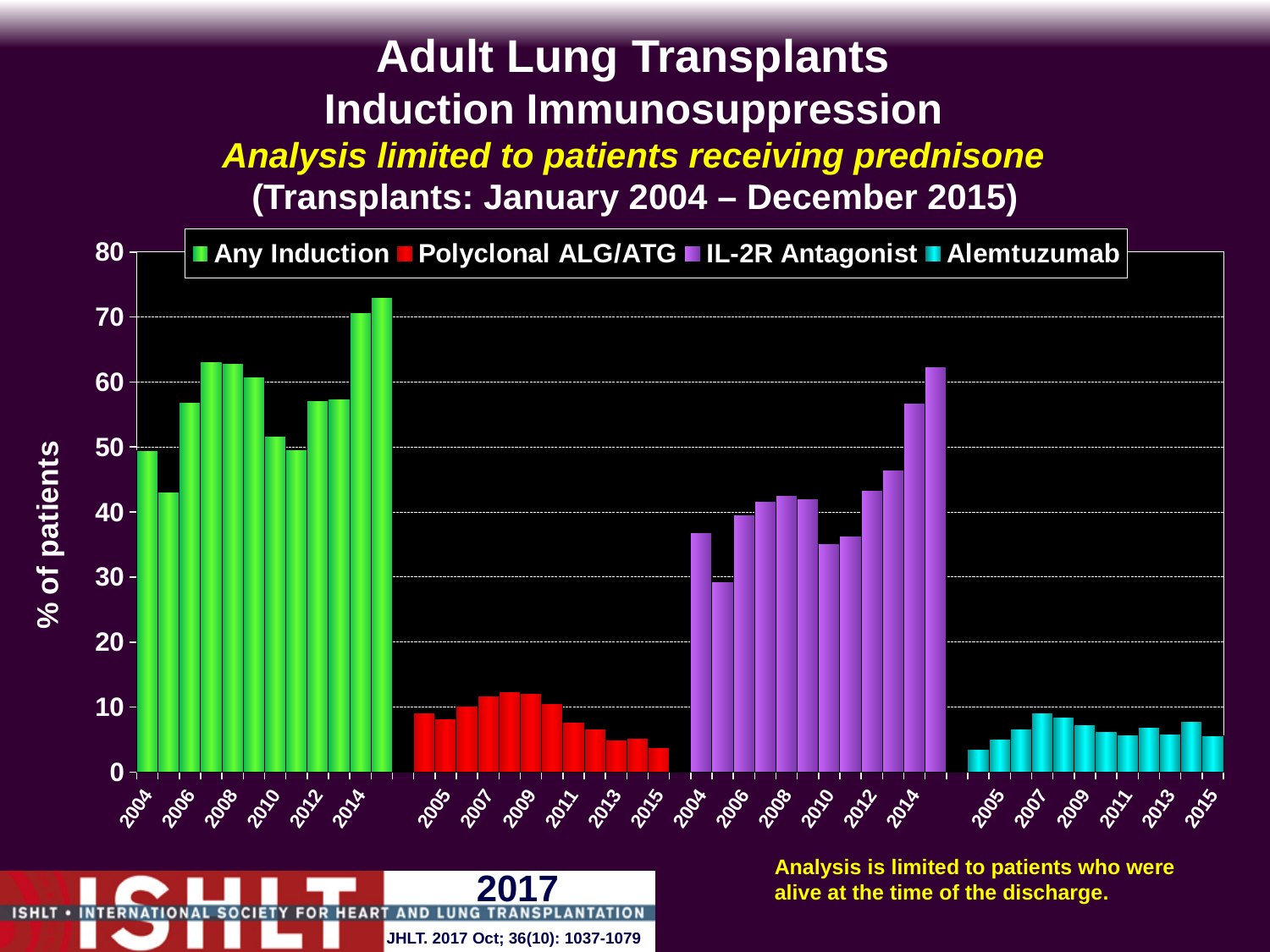
Is the Any Induction value for 2015 greater or less than 70? greater How many years (bars) are plotted for each series? 12 How many series does the legend list? 4 Do the Polyclonal ALG/ATG values rise or fall from 2009 to 2015? fall In which year is the Any Induction value highest? 2015 Is the IL-2R Antagonist value for 2015 greater or less than 60? greater What is the label on the vertical axis? % of patients What kind of chart is shown on the slide? bar chart Which is larger, the Polyclonal ALG/ATG value for 2008 or for 2015? 2008 In which year is the IL-2R Antagonist value lowest? 2005 In which year is the Any Induction value lowest? 2005